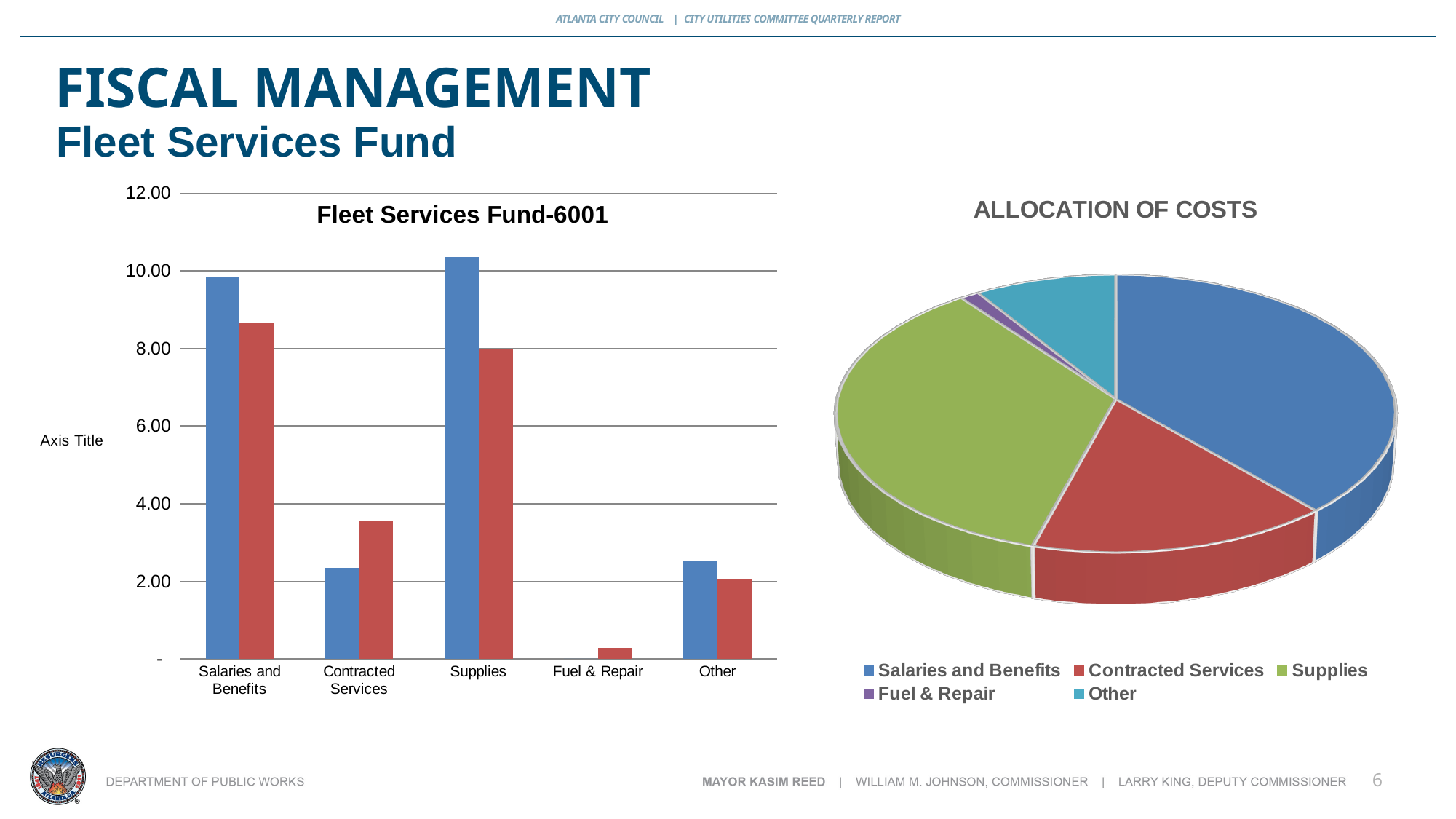
In the Fleet Services Fund-6001 bar chart, is the blue bar for Other greater or less than 2.00? greater In the Fleet Services Fund-6001 bar chart, which category has the shortest red bar? Fuel & Repair In the Fleet Services Fund-6001 bar chart, is the red bar for Contracted Services greater or less than 4.00? less How many entries does the legend of the ALLOCATION OF COSTS pie chart list? 5 How many categories are shown on the x axis of the Fleet Services Fund-6001 bar chart? 5 What kind of chart is the ALLOCATION OF COSTS chart on the right? pie chart In the Fleet Services Fund-6001 bar chart, which category has the tallest blue bar? Supplies In the ALLOCATION OF COSTS pie chart, which category has the smallest slice? Fuel & Repair What kind of chart is the Fleet Services Fund-6001 chart on the left? bar chart In the Fleet Services Fund-6001 bar chart, is the blue bar for Salaries and Benefits greater or less than 8.00? greater In the ALLOCATION OF COSTS pie chart, which category has the largest slice? Salaries and Benefits In the Fleet Services Fund-6001 bar chart, for Contracted Services, is the blue bar or the red bar taller? red bar